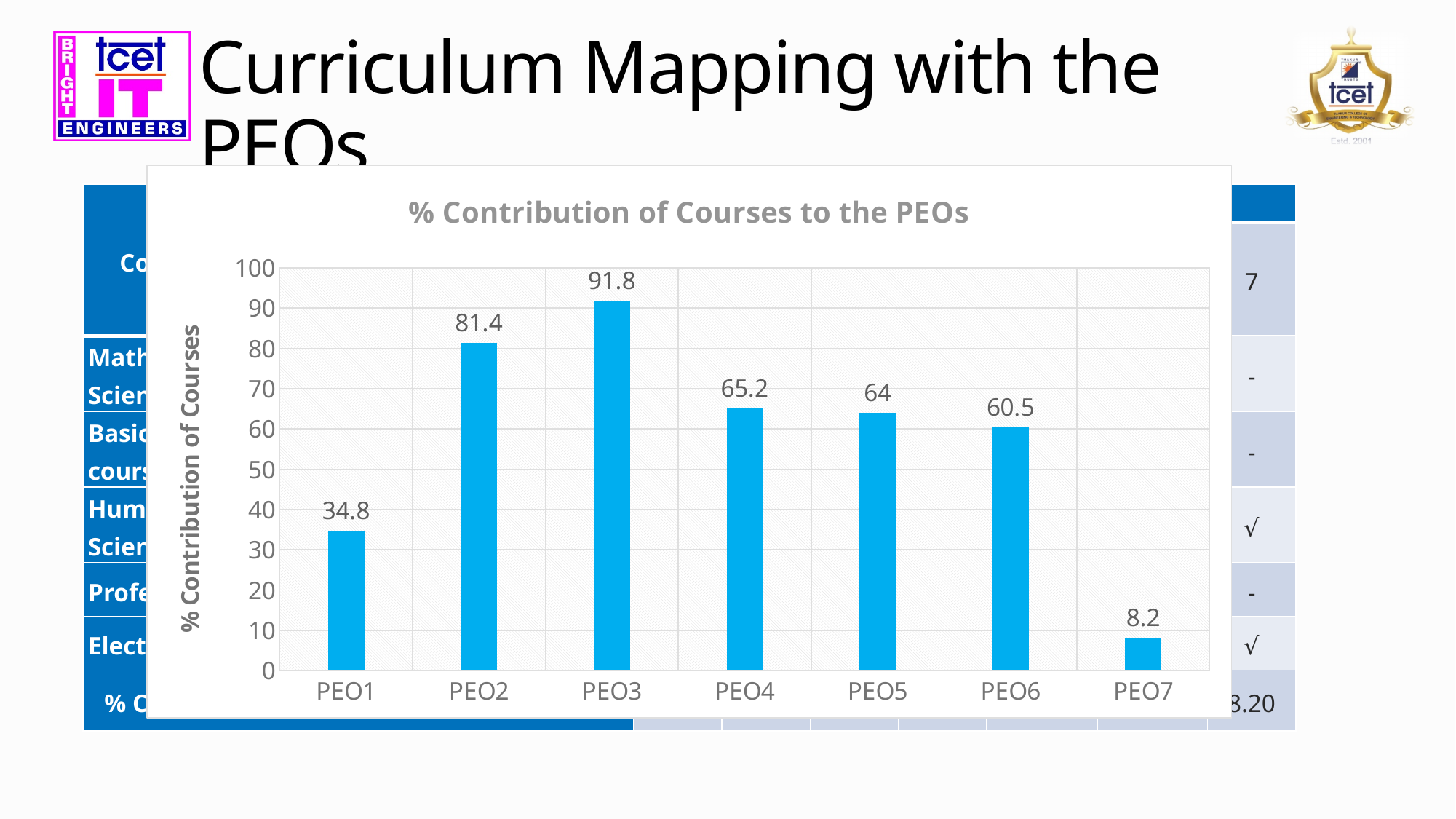
What is the % contribution of courses for PEO5? 64 What kind of chart is shown on the slide? bar chart Is the value for PEO1 greater or less than 40? less How many PEO categories are shown on the x axis? 7 Which has a larger value, PEO4 or PEO6? PEO4 What is the title of the chart? % Contribution of Courses to the PEOs Which PEO has the highest % contribution of courses? PEO3 What is the % contribution of courses for PEO3? 91.8 What is the % contribution of courses for PEO7? 8.2 What is the label of the vertical axis? % Contribution of Courses Which PEO has the lowest % contribution of courses? PEO7 What is the difference between the values for PEO2 and PEO1? 46.6